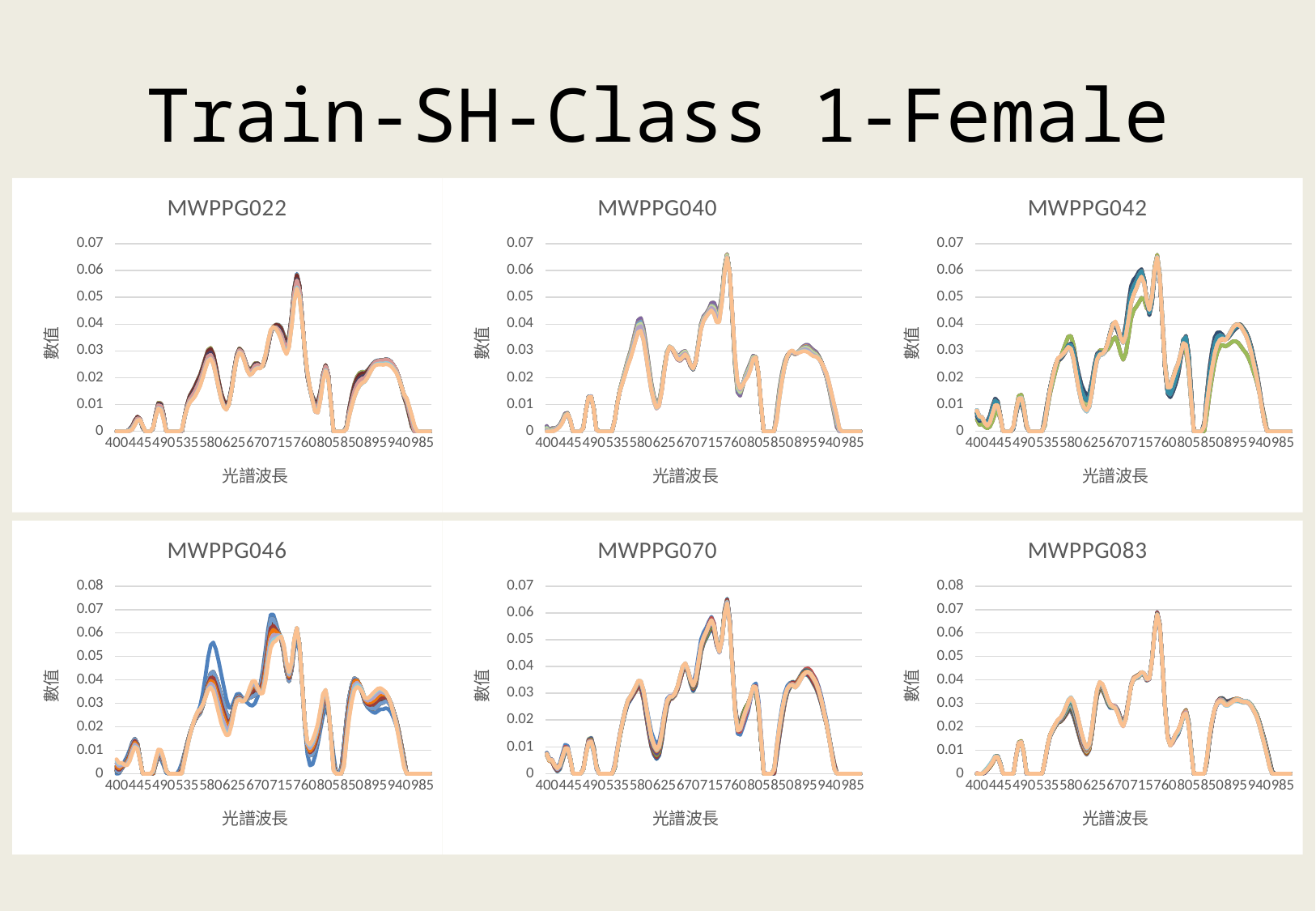
In the MWPPG070 chart, is the value at 985 greater or less than 0.01? less In the MWPPG022 chart, is the peak value of the lines greater or less than 0.05? greater What is the title of the top-left chart? MWPPG022 How many charts are shown on the slide? 6 In the MWPPG022 chart, what is the highest value shown on the y axis? 0.07 In the MWPPG022 chart, is the value at 400 greater or less than 0.01? less What kind of chart is MWPPG022? line chart What is the x-axis label on the MWPPG040 chart? 光譜波長 In the MWPPG046 chart, what is the highest value shown on the y axis? 0.08